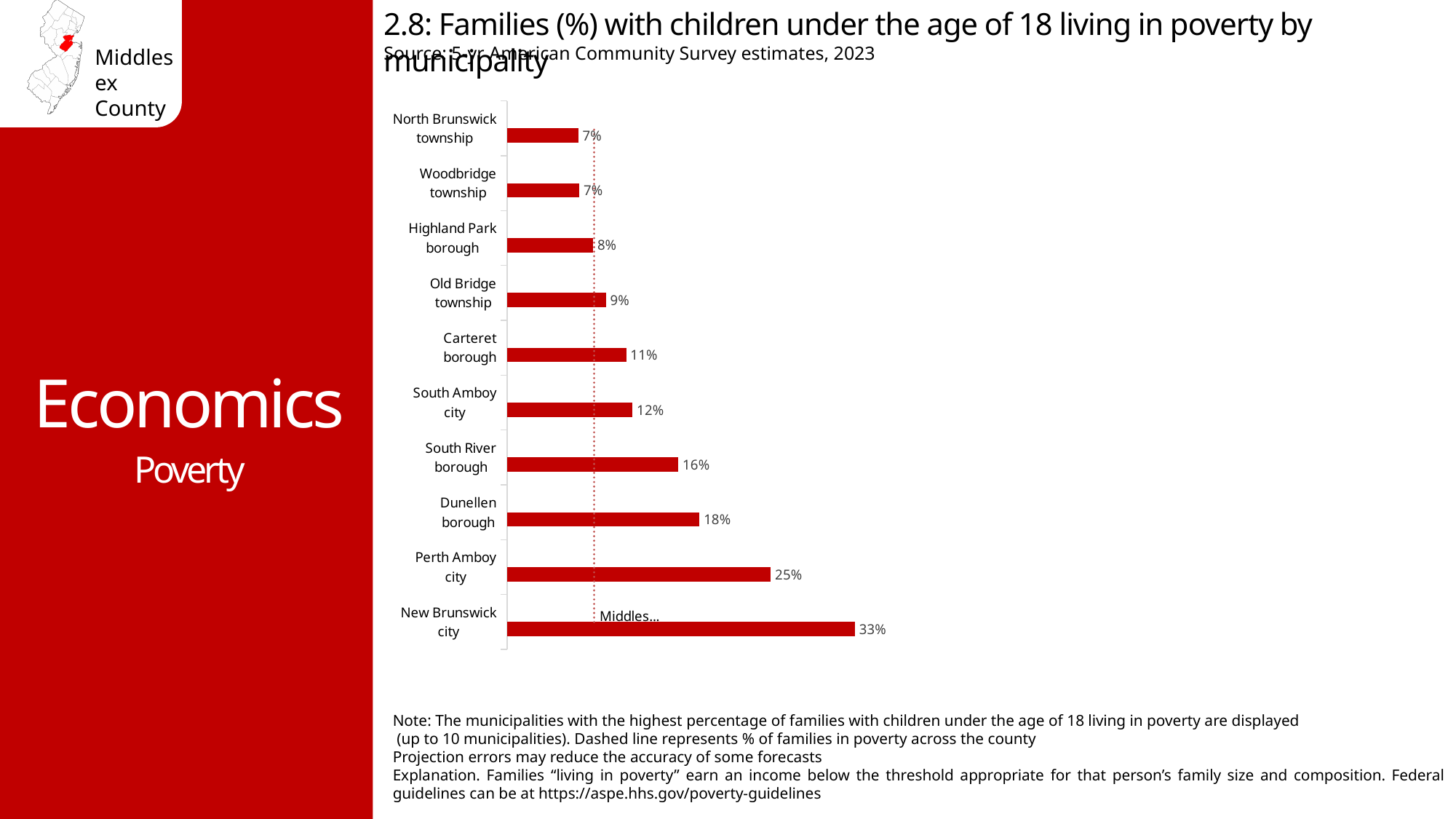
What percentage of families with children under 18 live in poverty in New Brunswick city? 33% What is the value shown for Perth Amboy city? 25% Which has a higher value, South Amboy city or Highland Park borough? South Amboy city What kind of chart is shown on the slide? Bar chart How many municipalities are shown on the chart? 10 What is the difference between the values for New Brunswick city and Perth Amboy city? 8% What is the difference between the values for Dunellen borough and Carteret borough? 7% According to the note, what does the dashed line on the chart represent? % of families in poverty across the county What is the value shown for South River borough? 16% Which municipality has the highest percentage of families with children under 18 living in poverty? New Brunswick city What is the value shown for Old Bridge township? 9% Which municipality has the lowest value shown on the chart? North Brunswick township and Woodbridge township (both 7%)